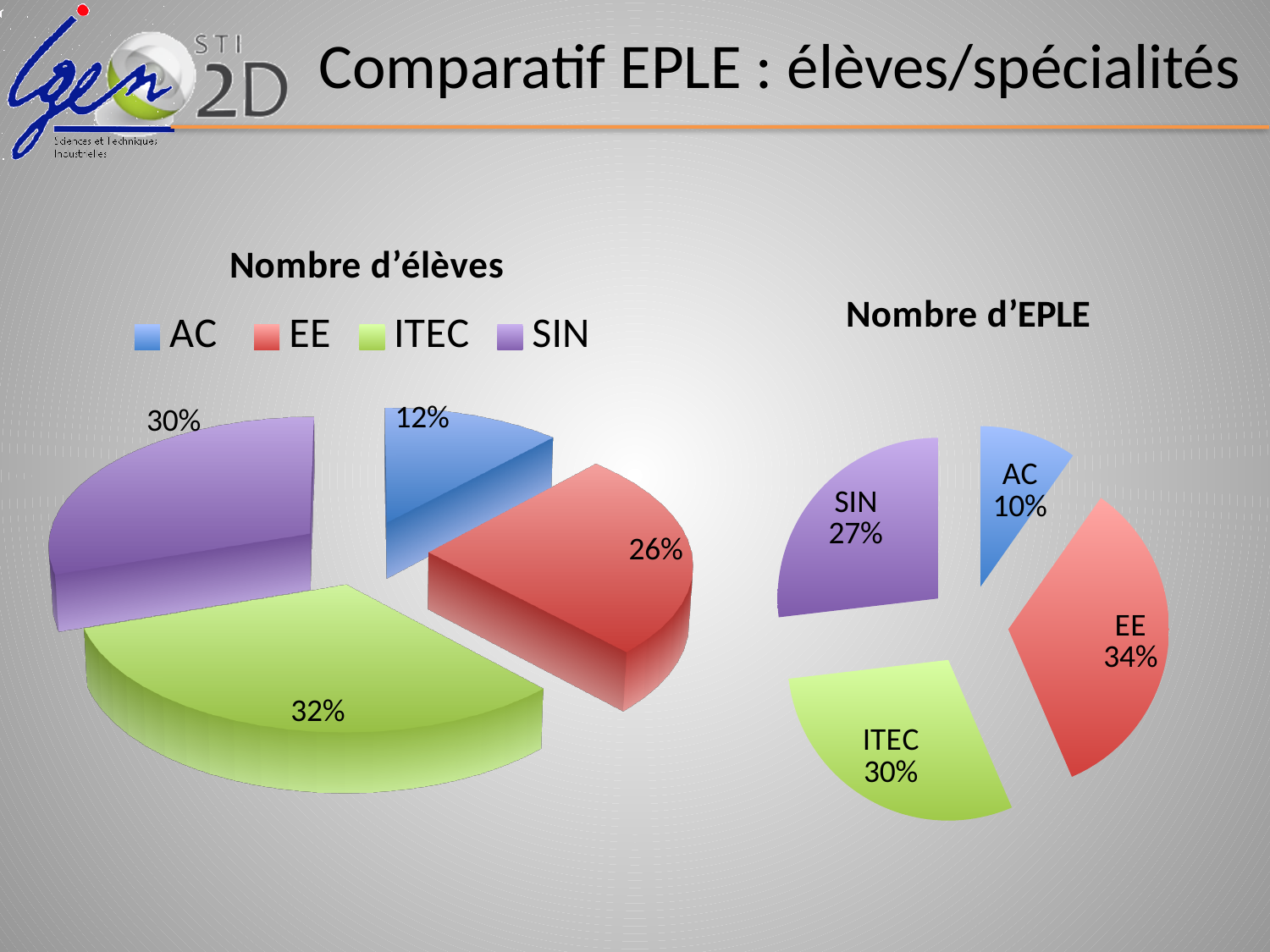
How many slices does the "Nombre d'élèves" chart have? 4 In the "Nombre d'EPLE" chart, which specialty has the smallest slice? AC What kind of chart is the "Nombre d'EPLE" chart? Pie chart In the "Nombre d'EPLE" chart, is the share for EE or for ITEC larger? EE In the "Nombre d'élèves" chart, which specialty has the largest slice? ITEC In the "Nombre d'élèves" chart, what share does AC have? 12% In the "Nombre d'EPLE" chart, which specialty has the largest slice? EE In the "Nombre d'élèves" chart, what share does ITEC have? 32% In the "Nombre d'élèves" chart, what is the difference between the SIN share and the AC share? 18% In the "Nombre d'EPLE" chart, what share does SIN have? 27% Which colour represents SIN in the "Nombre d'élèves" chart legend? Purple